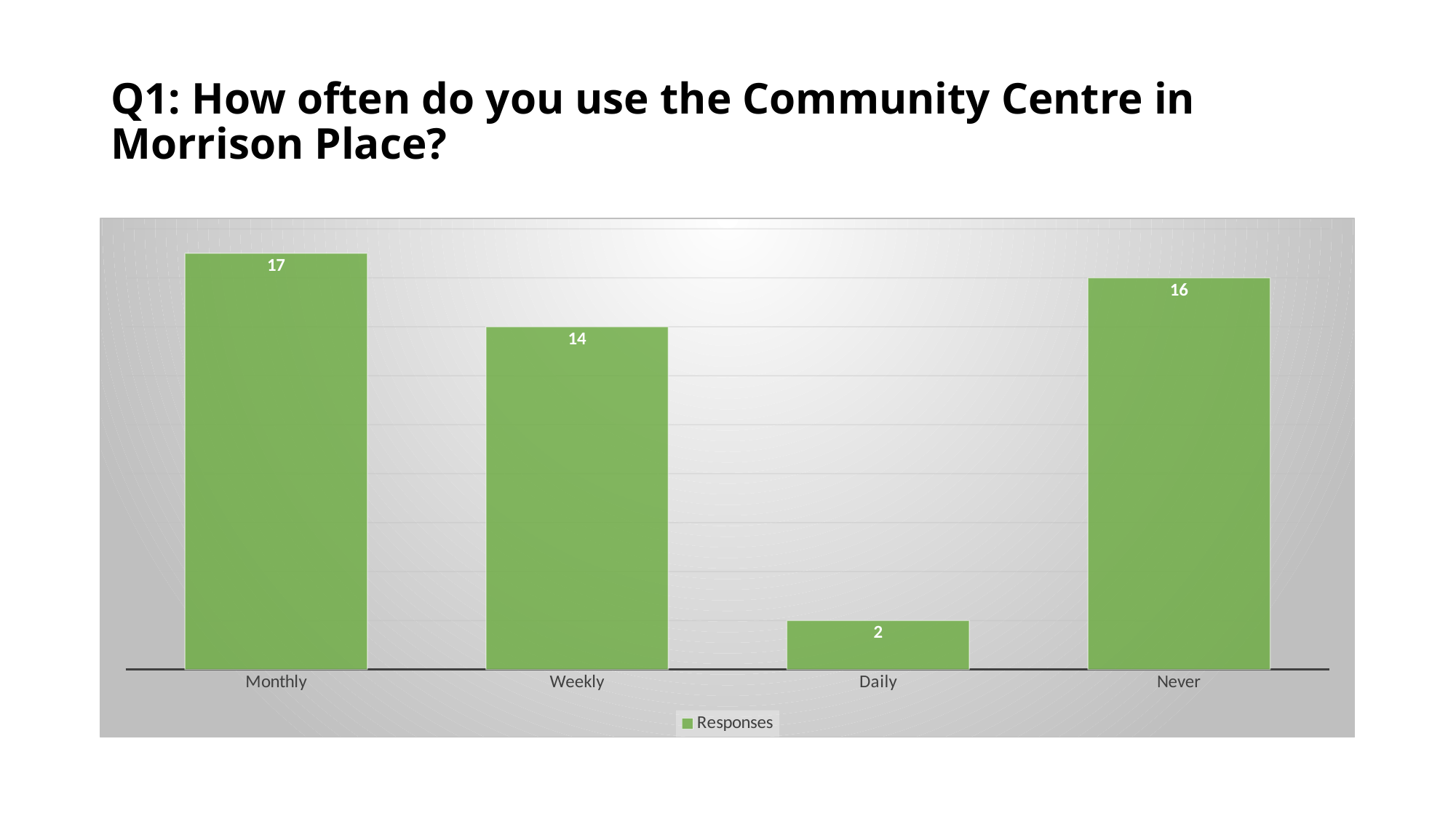
What is the difference between the Never and Daily values? 14 How many responses are shown for Monthly? 17 Which category has the highest number of responses? Monthly What is the value for Daily? 2 What is the value for Weekly? 14 How many series does the legend list? 1 How many categories are shown on the x axis? 4 What is the difference between the Monthly and Weekly values? 3 What is the value for Never? 16 Which category has the lowest number of responses? Daily What kind of chart is shown on the slide? Bar chart Which is larger, the value for Weekly or the value for Never? Never